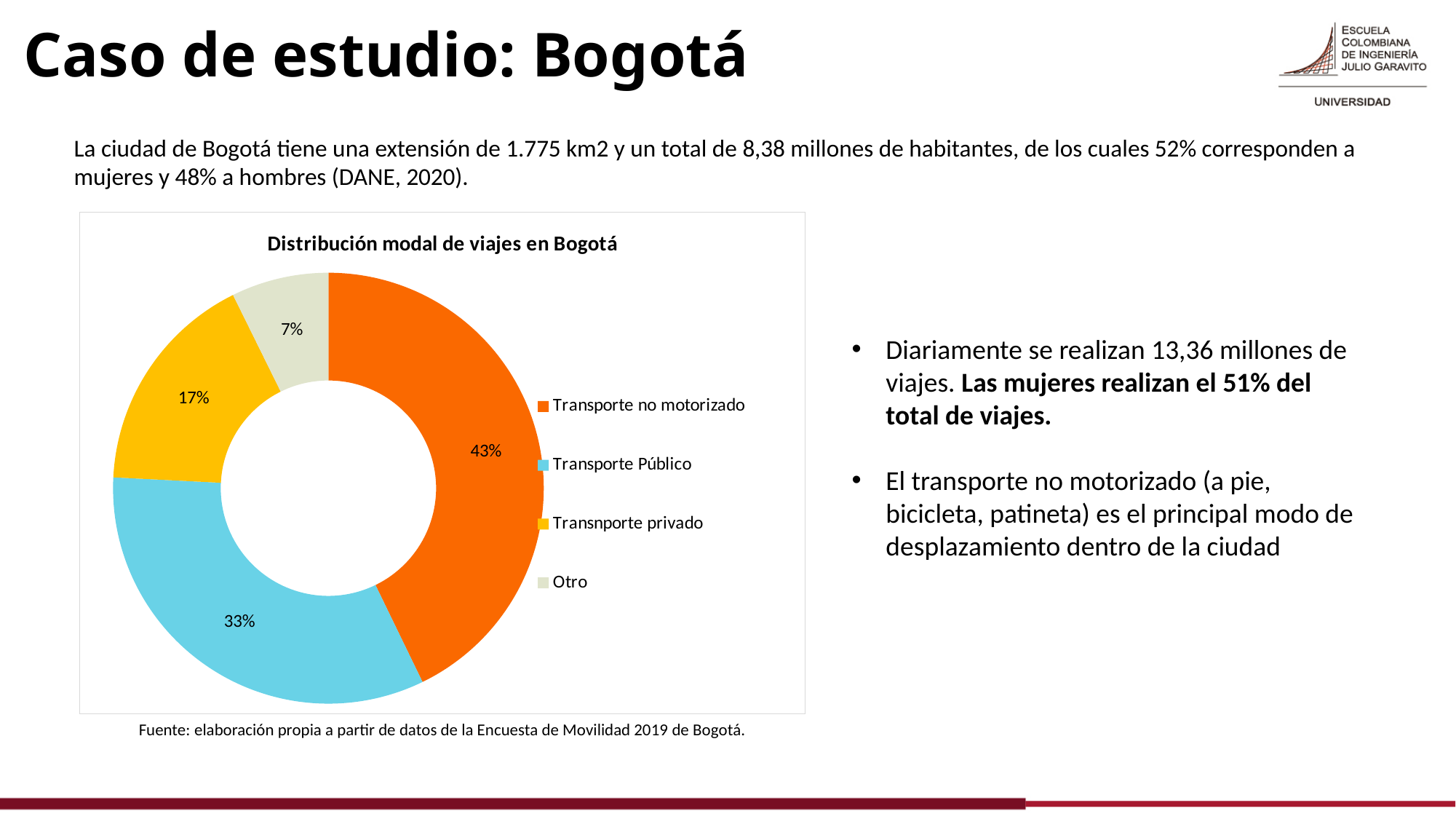
What percentage is shown for Transnporte privado? 17% What is the difference in percentage points between Transporte no motorizado and Transporte Público? 10 What share of trips does Transporte no motorizado account for in the chart? 43% Which is larger, the share for Transnporte privado or the share for Otro? Transnporte privado What is the title of the chart? Distribución modal de viajes en Bogotá How many categories does the chart show? 4 What percentage is shown for Transporte Público? 33% What percentage is shown for the Otro category? 7% Which category has the smallest share of trips? Otro Which category has the largest share of trips? Transporte no motorizado What colour represents Transporte Público in the chart? Light blue What kind of chart is shown on the slide? Pie chart (doughnut)